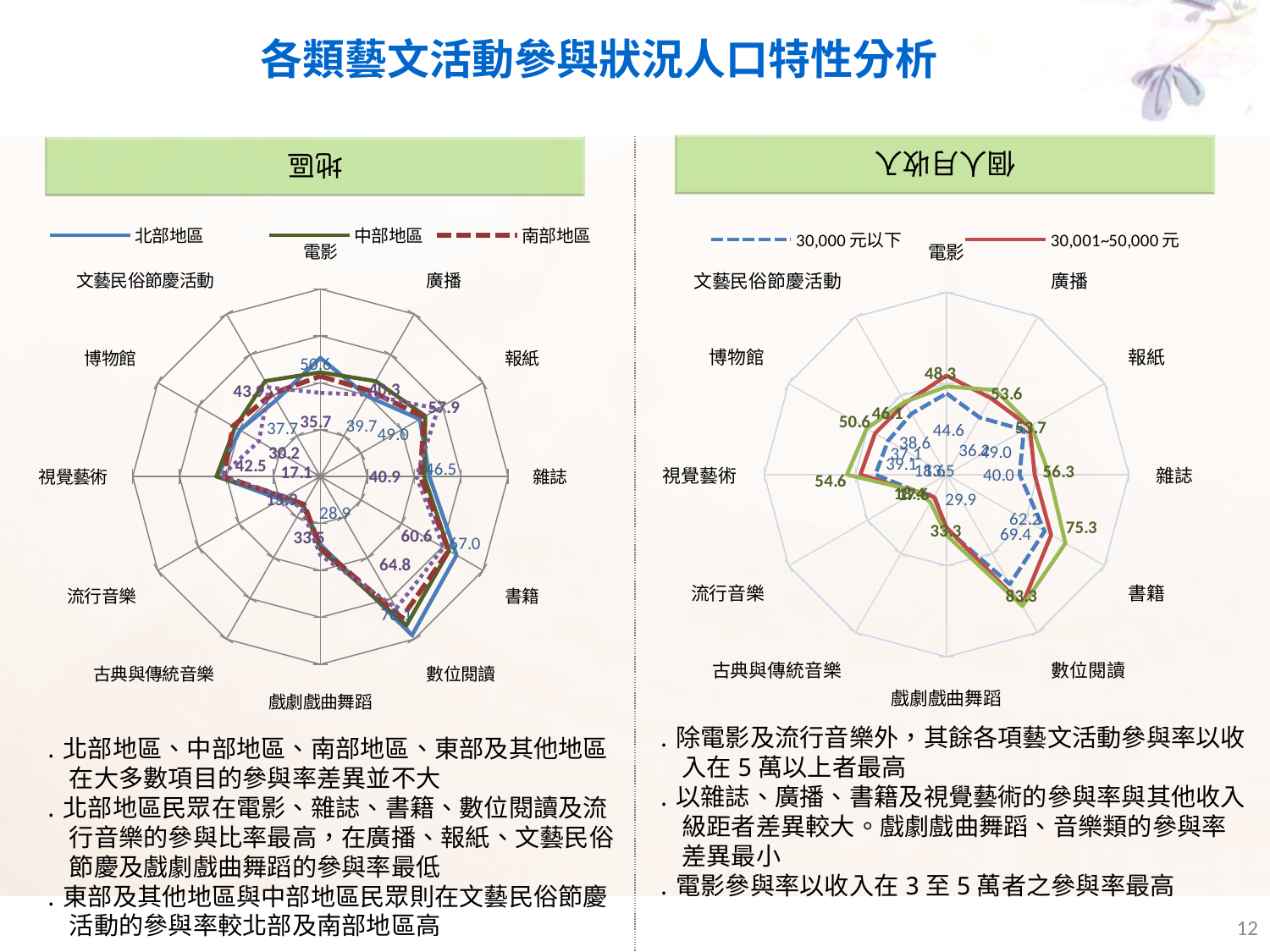
In the right (個人收入) chart, is the participation value for 書籍 larger or smaller than that for 戲劇戲曲舞蹈? Larger What kind of chart is shown on the right side of the slide under the heading 個人收入? Radar chart In the right (個人收入) chart, which activity category has the highest participation value? 數位閱讀 How many series does the legend of the left (地區) chart list? 3 In the right (個人收入) chart, what is the largest data label printed at 書籍? 75.3 In the left (地區) chart, which activity category reaches the furthest from the centre (highest values)? 數位閱讀 What kind of chart is shown on the left side of the slide under the heading 地區? Radar chart Which series is drawn as a dashed line in the legend of the right (個人收入) chart? 30,000 元以下 How many activity categories are plotted around the left (地區) radar chart? 12 Which series is drawn as a dashed line in the legend of the left (地區) chart? 南部地區 In the right (個人收入) chart, what is the largest data label printed at 數位閱讀? 83.3 How many series does the legend of the right (個人收入) chart list? 2